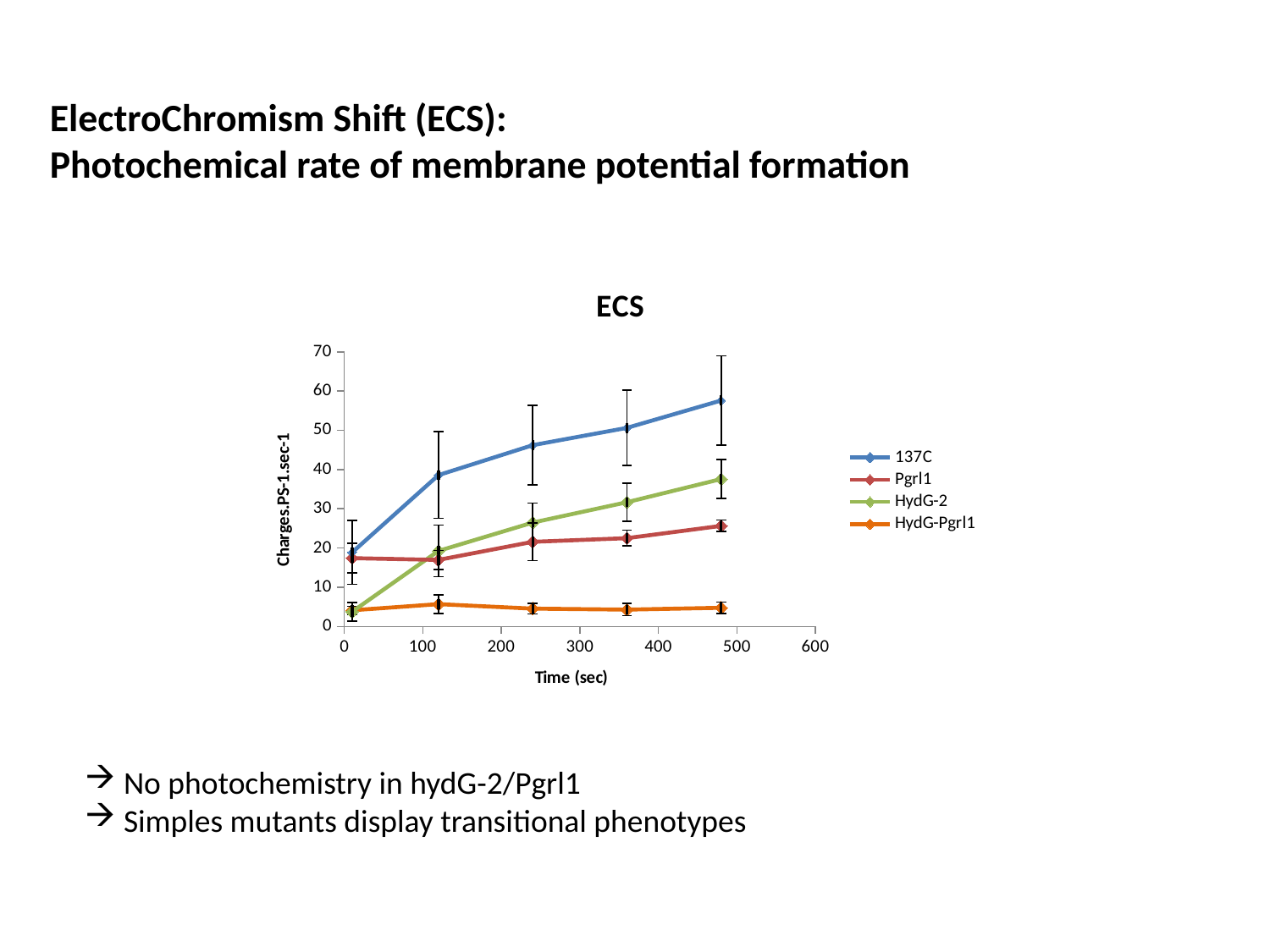
What kind of chart is shown on the slide? line chart Does the 137C series rise or fall as time increases? rise Which series has the lowest value at the last time point (around 480 sec)? HydG-Pgrl1 At around 240 sec, which series has the larger value, HydG-2 or Pgrl1? HydG-2 Is the value for HydG-Pgrl1 at the last time point (around 480 sec) greater or less than 10? less What is the title of the chart? ECS What is the label of the x axis of the ECS chart? Time (sec) How many series does the legend of the ECS chart list? 4 Is the value for HydG-2 at the last time point (around 480 sec) greater or less than 30? greater Which series has the highest value at the last time point (around 480 sec)? 137C How many data points are plotted for the 137C series? 5 Is the value for 137C at the last time point (around 480 sec) greater or less than 50? greater